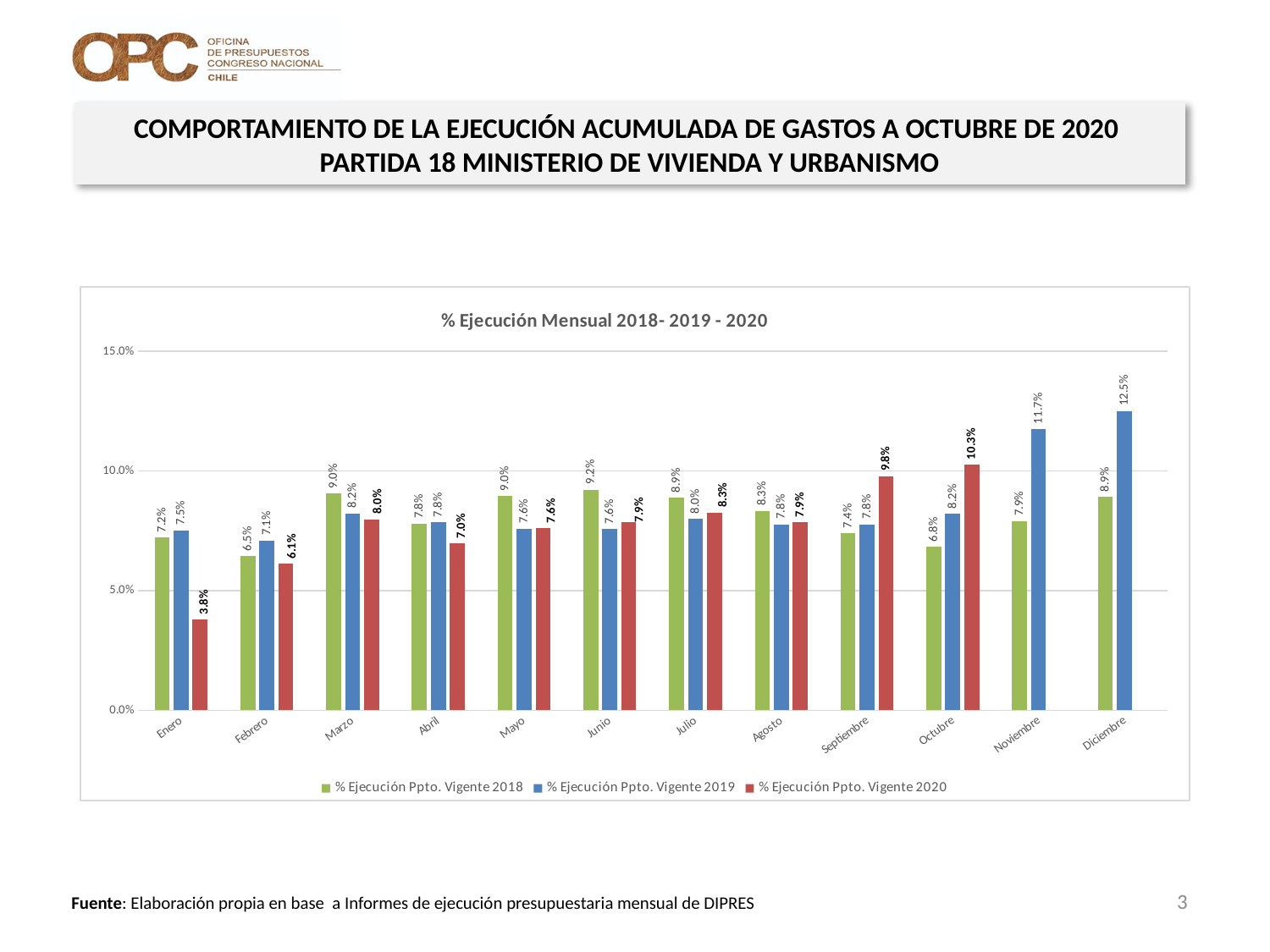
Is the value for % Ejecución Ppto. Vigente 2019 in Diciembre greater or less than 10.0%? greater In Marzo, which series has the larger value: % Ejecución Ppto. Vigente 2018 or % Ejecución Ppto. Vigente 2020? % Ejecución Ppto. Vigente 2018 What is the value for % Ejecución Ppto. Vigente 2019 in Noviembre? 11.7% What is the value for % Ejecución Ppto. Vigente 2020 in Enero? 3.8% What is the value for % Ejecución Ppto. Vigente 2018 in Junio? 9.2% How many months are shown on the x axis? 12 Which month has the lowest value for % Ejecución Ppto. Vigente 2020? Enero What is the difference between the 2020 and 2018 values in Octubre? 3.5% What is the title of the chart? % Ejecución Mensual 2018- 2019 - 2020 What kind of chart is shown on the slide? Bar chart How many series does the legend list? 3 Which month has the highest value for % Ejecución Ppto. Vigente 2019? Diciembre